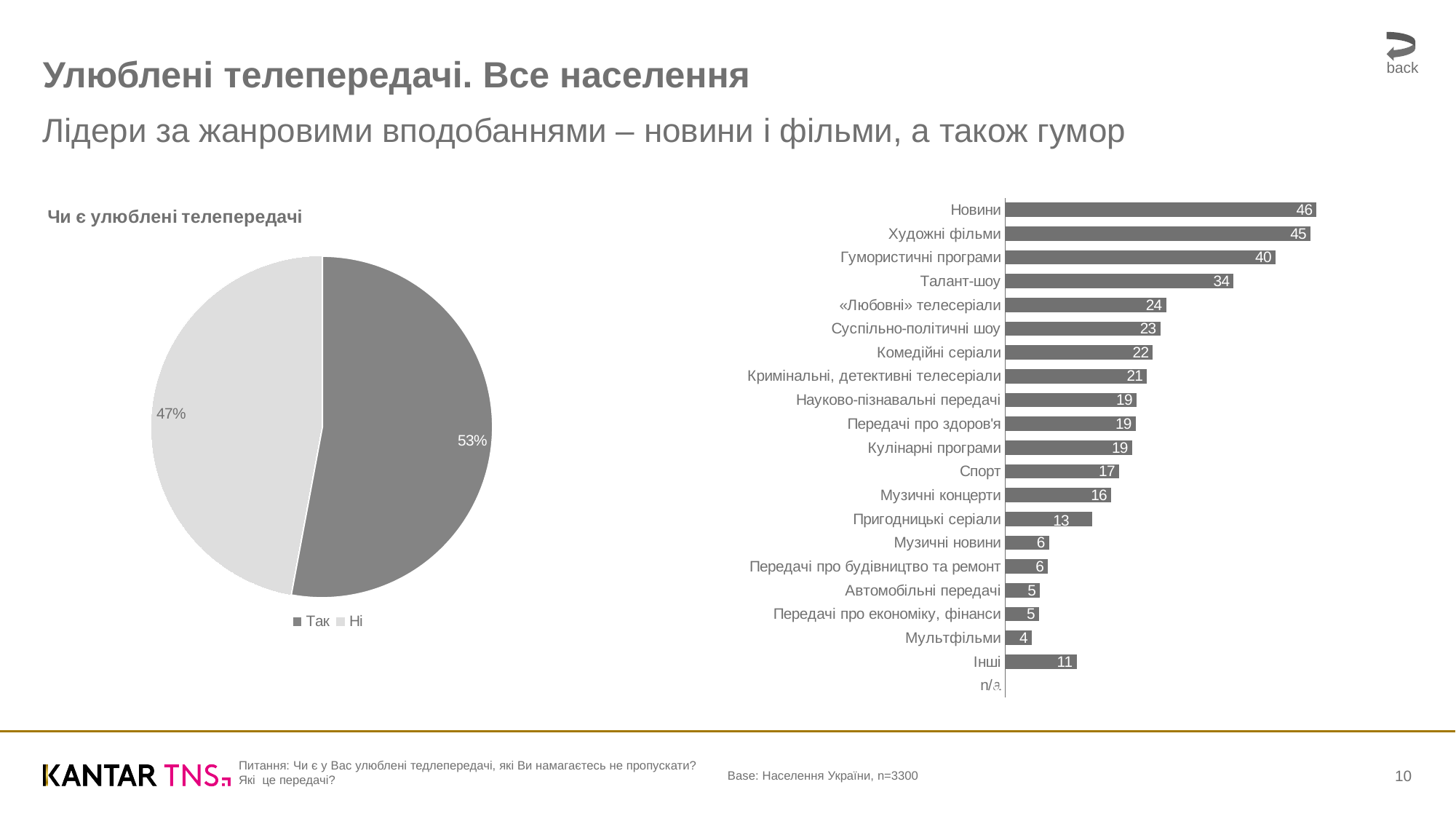
In the bar chart on the right, what is the value for 'Талант-шоу'? 34 In the pie chart 'Чи є улюблені телепередачі', how many slices are there? 2 In the pie chart 'Чи є улюблені телепередачі', what share is labelled 'Ні'? 47% What kind of chart is the chart on the left of the slide? Pie chart In the bar chart on the right, what is the difference between 'Художні фільми' and 'Гумористичні програми'? 5 In the bar chart on the right, which is larger, 'Спорт' or 'Музичні концерти'? Спорт In the bar chart on the right, which category has the lowest labelled value? Мультфільми What kind of chart is the chart on the right of the slide? Bar chart In the pie chart 'Чи є улюблені телепередачі', what share is labelled 'Так'? 53% In the bar chart on the right, what is the value for 'Новини'? 46 In the bar chart on the right, which category has the highest value? Новини In the pie chart 'Чи є улюблені телепередачі', which slice is larger, 'Так' or 'Ні'? Так